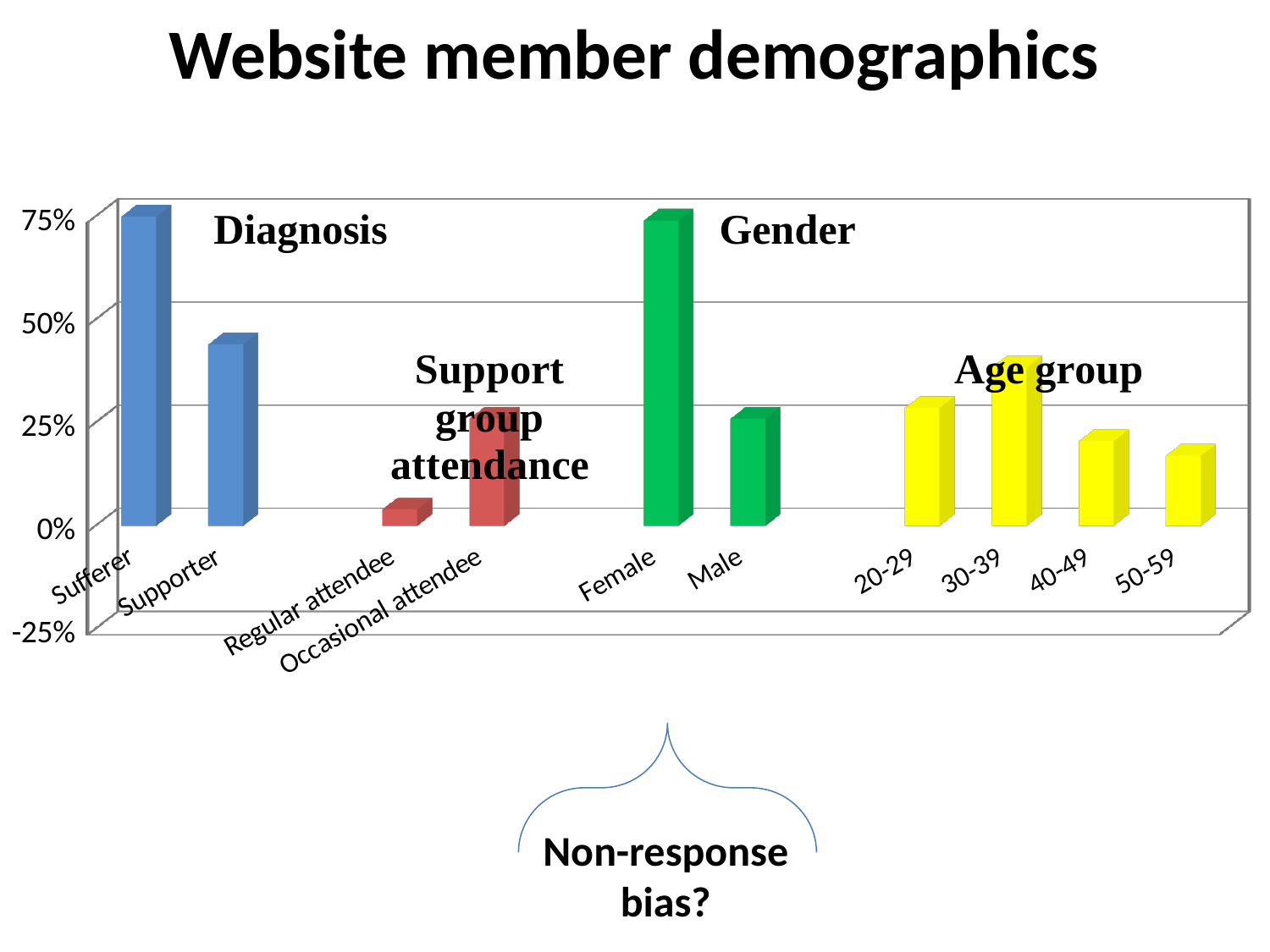
What kind of chart is shown on the slide? bar chart What is the title of the slide containing the chart? Website member demographics How many categories are plotted along the x axis of the chart? 10 Is the value for 50-59 greater or less than 25%? less Is the value for Regular attendee greater or less than 25%? less Is the value for 30-39 greater or less than 25%? greater Which is larger, the value for Regular attendee or the value for Occasional attendee? Occasional attendee Which category has the lowest value in the chart? Regular attendee Which age group has the highest value? 30-39 Which is larger, the value for Female or the value for Male? Female